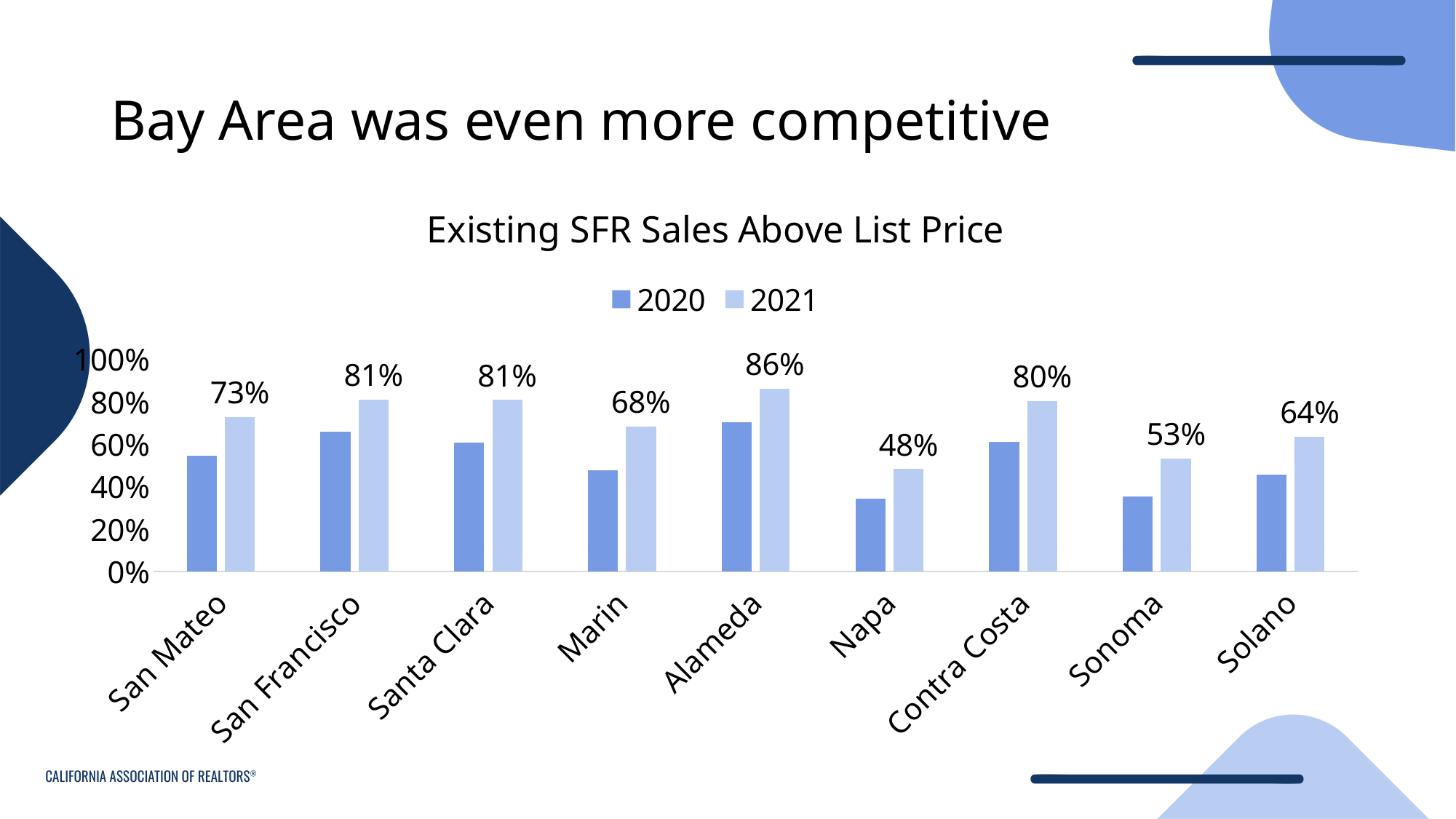
What kind of chart is shown on the slide? Bar chart Is the 2020 value for Napa greater or less than 40%? less What is the 2021 value for Solano? 64% What is the difference between the 2021 values for Alameda and Napa? 38 percentage points What is the 2021 value for Napa? 48% What is the 2021 value for Alameda? 86% Which is larger, the 2021 value for Marin or the 2021 value for Sonoma? Marin Which county has the highest 2021 value? Alameda How many series does the legend list? 2 Which county has the lowest 2021 value? Napa How many counties are shown on the x axis? 9 Is the 2020 value for Alameda greater or less than 60%? greater